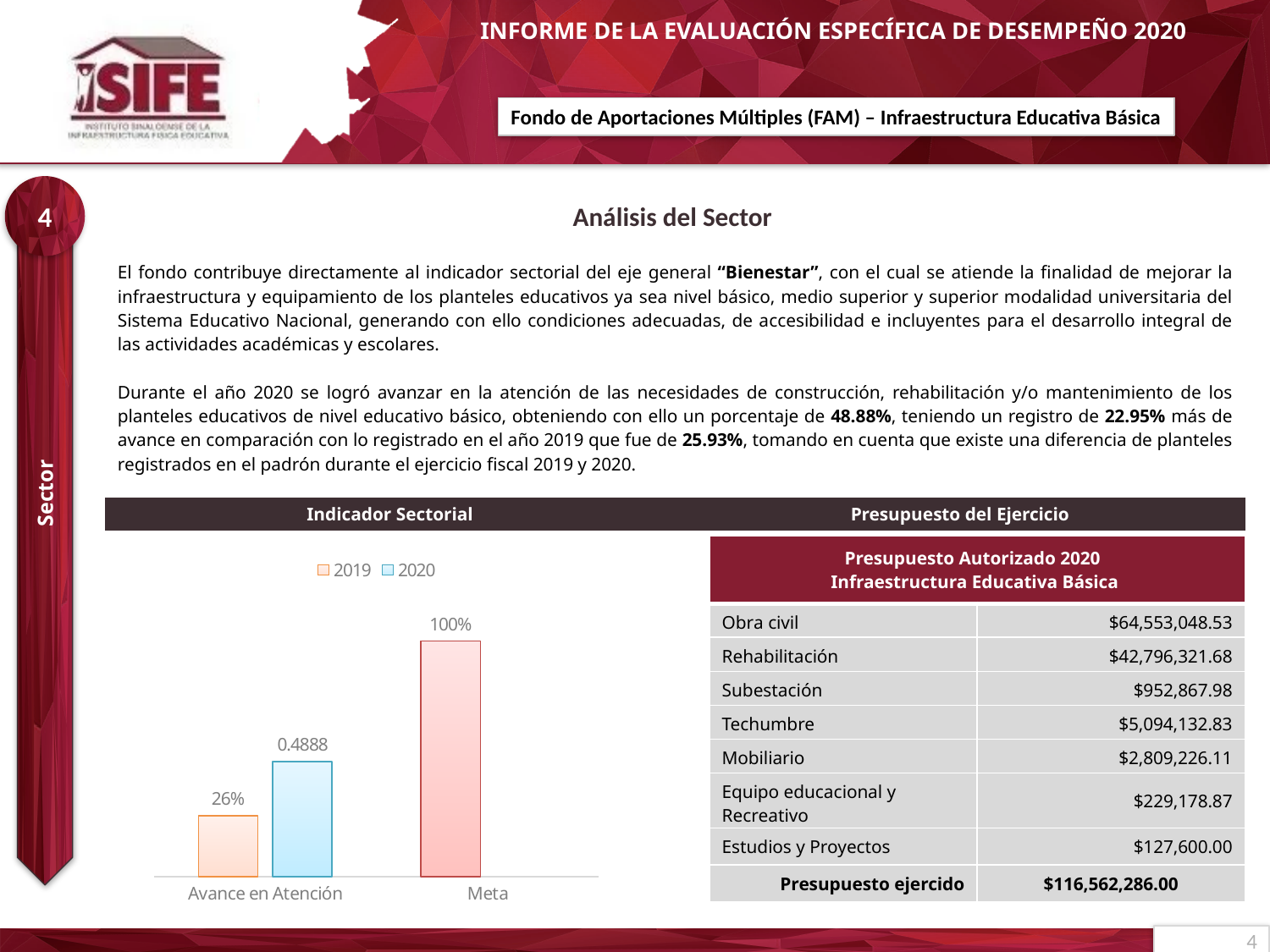
In the 'Indicador Sectorial' chart, for 'Avance en Atención', which series has the larger value, 2019 or 2020? 2020 In the 'Indicador Sectorial' chart, what is the difference between the 'Meta' value and the 2019 'Avance en Atención' value? 74% What are the legend entries of the 'Indicador Sectorial' chart? 2019 and 2020 In the 'Indicador Sectorial' chart, what value is labeled on the 'Meta' bar? 100% In the 'Indicador Sectorial' chart, what is the 2020 value for 'Avance en Atención'? 0.4888 In the 'Indicador Sectorial' chart, which bar has the highest value? Meta What kind of chart is shown under the 'Indicador Sectorial' heading? bar chart What are the category labels on the x axis of the 'Indicador Sectorial' chart? Avance en Atención and Meta How many categories are shown on the x axis of the 'Indicador Sectorial' chart? 2 How many series does the legend of the 'Indicador Sectorial' chart list? 2 In the 'Indicador Sectorial' chart, what is the 2019 value for 'Avance en Atención'? 26% In the 'Indicador Sectorial' chart, which bar has the lowest value? 2019 Avance en Atención